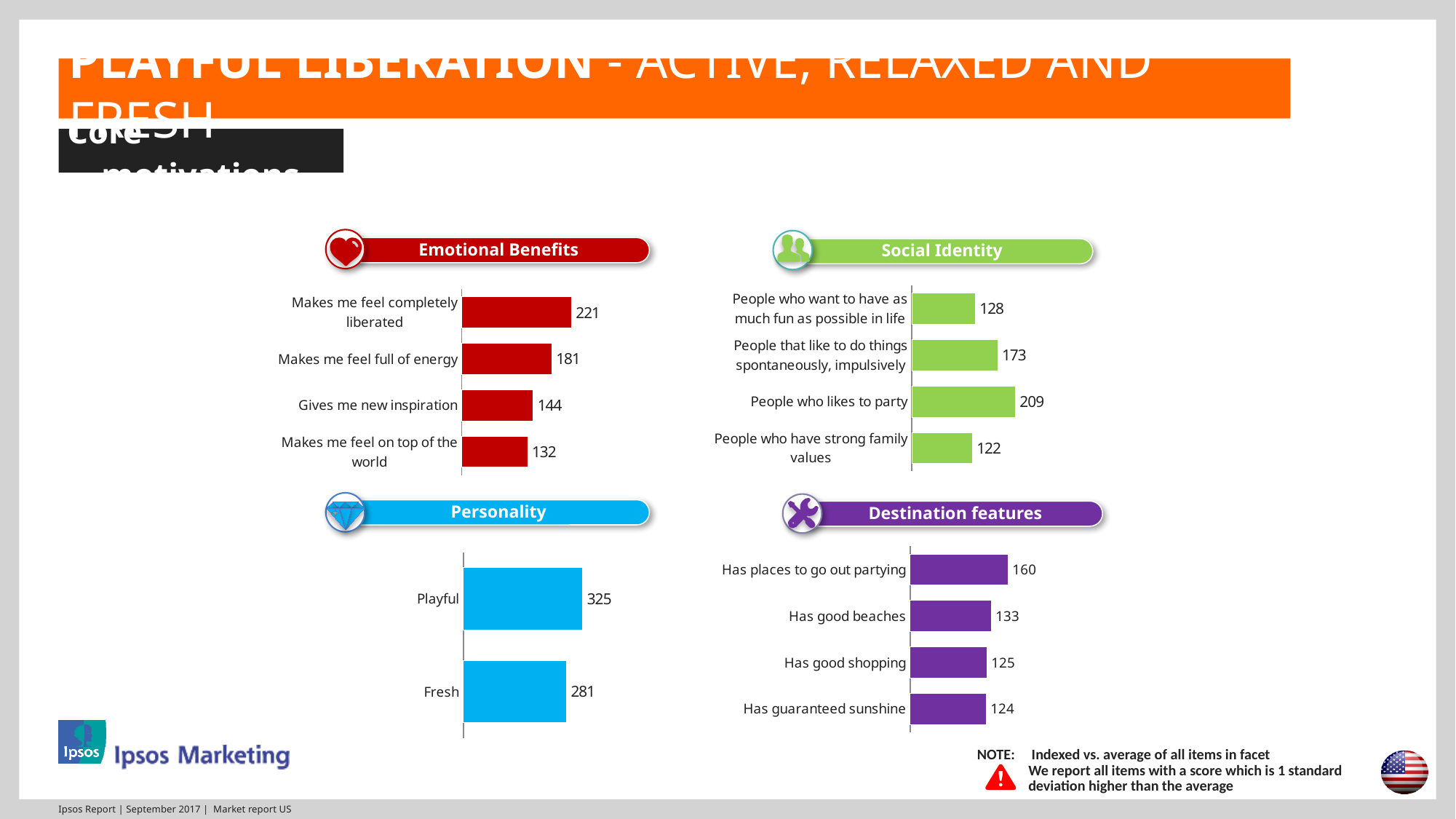
What kind of chart is the Destination features chart? Bar chart In the Social Identity chart, how many categories are shown? 4 In the Social Identity chart, what is the value for "People who have strong family values"? 122 In the Personality chart, what is the value for "Fresh"? 281 In the Emotional Benefits chart, which category has the lowest value? Makes me feel on top of the world In the Emotional Benefits chart, what is the difference between "Makes me feel full of energy" and "Gives me new inspiration"? 37 In the Destination features chart, what is the value for "Has places to go out partying"? 160 In the Social Identity chart, which category has the highest value? People who likes to party In the Personality chart, what is the difference between "Playful" and "Fresh"? 44 In the Emotional Benefits chart, what is the value for "Makes me feel completely liberated"? 221 In the Destination features chart, which is larger: "Has good beaches" or "Has good shopping"? Has good beaches How many charts are shown on the slide? 4